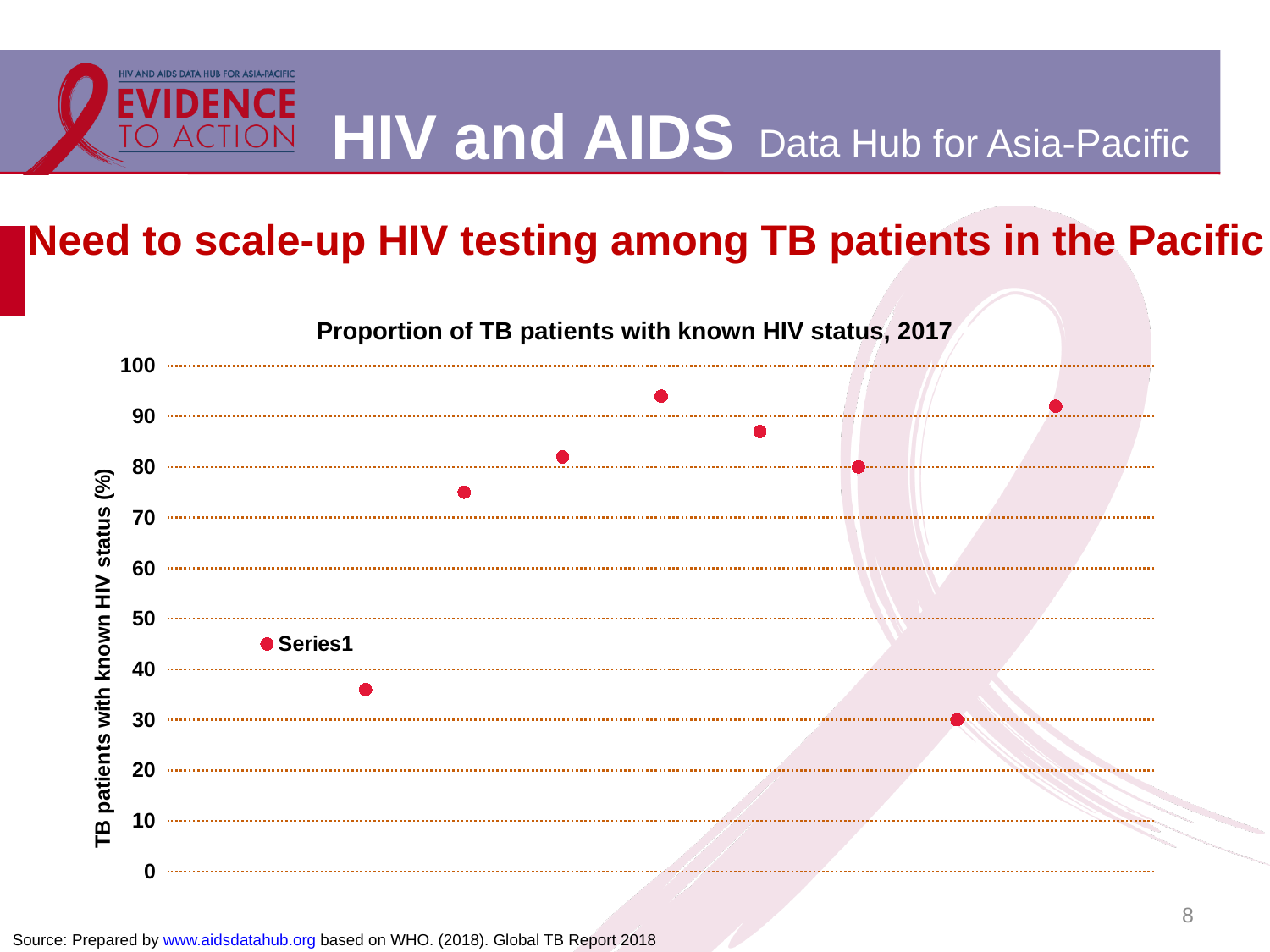
How many plotted points lie above 90 on the vertical axis? 2 What is the label of the vertical axis? TB patients with known HIV status (%) What is the title of the chart? Proportion of TB patients with known HIV status, 2017 How many data points are plotted on the chart? 9 What kind of chart is shown on the slide? Scatter (dot) chart Is the highest plotted point greater or less than 90? greater What is the maximum value shown on the vertical axis? 100 Is the lowest plotted point greater or less than 20? greater Is the lowest plotted point greater or less than 40? less How many plotted points lie below 50 on the vertical axis? 3